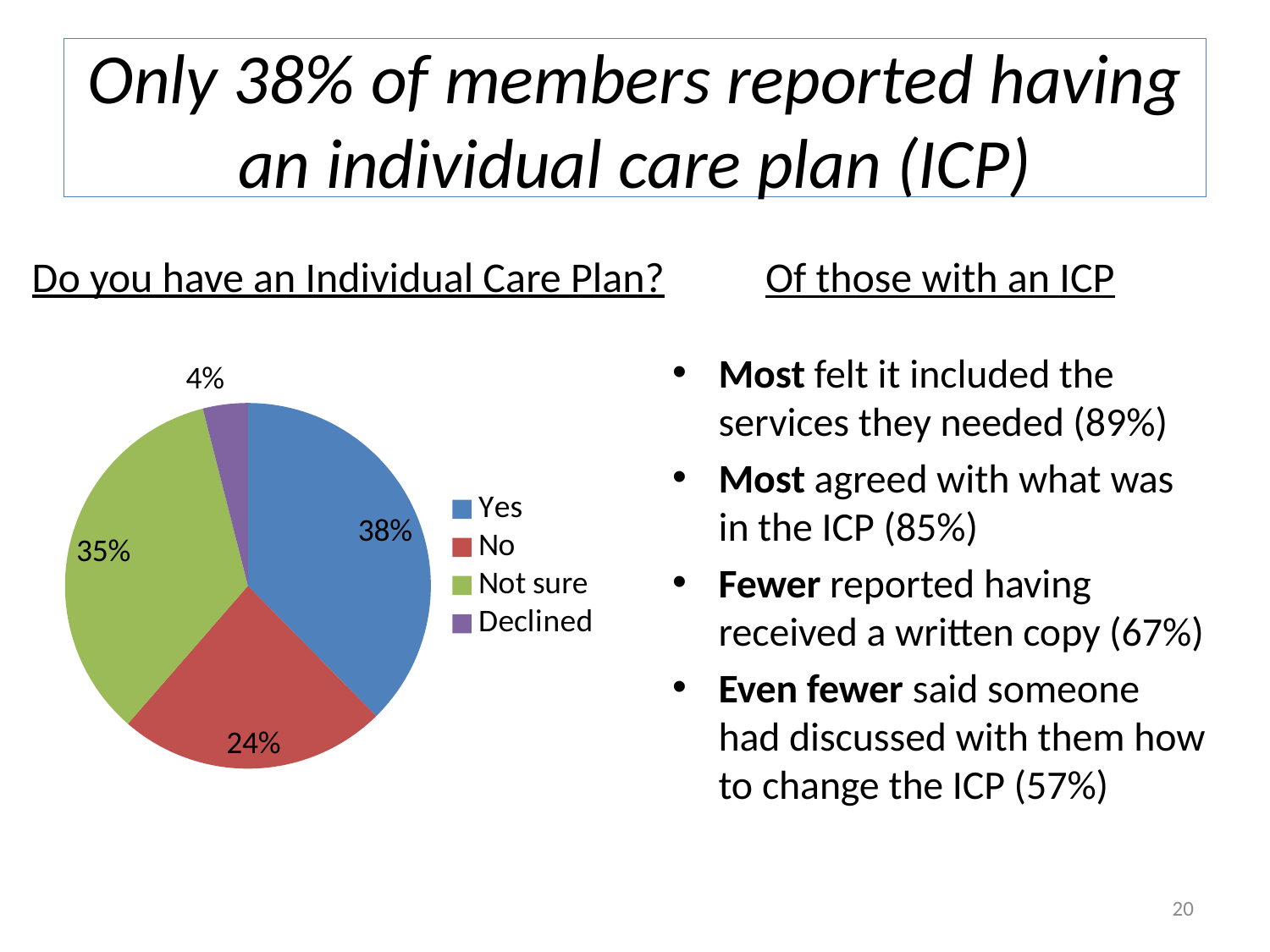
Which slice is larger, "Not sure" or "No"? Not sure What type of chart is shown on the slide? Pie chart What colour is the "Not sure" slice in the pie chart? Green What question does the pie chart answer, according to the heading above it? Do you have an Individual Care Plan? What percentage of members answered "No" in the pie chart? 24% What percentage of members "Declined" to answer? 4% How many categories does the pie chart show? 4 Which response category has the largest share of the pie chart? Yes What percentage of members answered "Not sure"? 35% What percentage of members answered "Yes" to having an Individual Care Plan? 38% Which response category has the smallest share of the pie chart? Declined What is the difference in percentage points between the "Yes" and "No" slices? 14